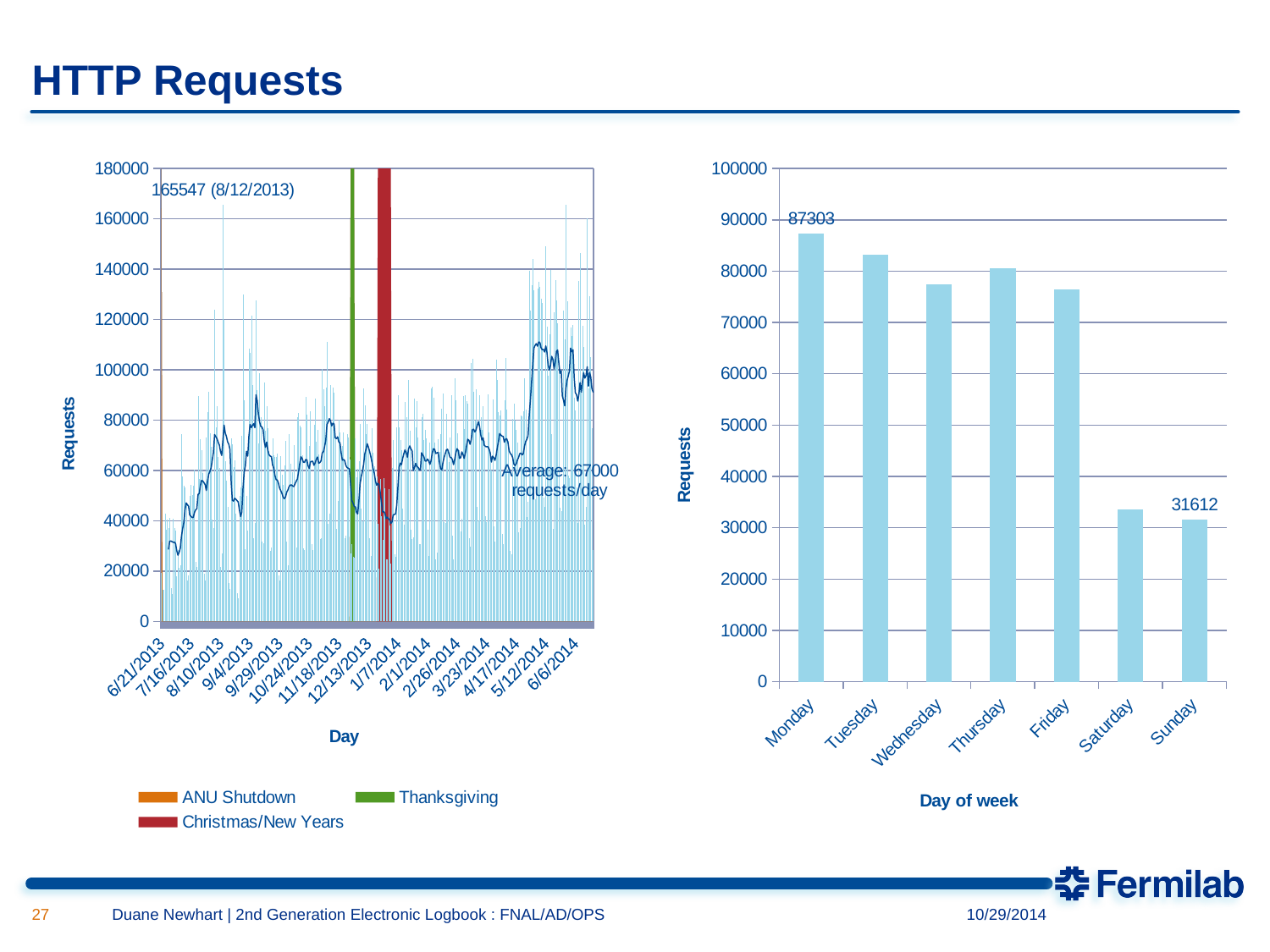
What kind of chart is the right chart (requests by day of week)? bar chart In the right chart (requests by day of week), which is larger, the value for Tuesday or the value for Wednesday? Tuesday In the right chart (requests by day of week), is the value for Tuesday greater or less than 80000? greater In the right chart (requests by day of week), what is the value for Monday? 87303 In the right chart (requests by day of week), what is the value for Sunday? 31612 In the right chart (requests by day of week), is the value for Wednesday greater or less than 80000? less In the left chart (requests per day), what peak value and date are annotated at the top? 165547 (8/12/2013) In the right chart (requests by day of week), which day has the highest number of requests? Monday How many days of the week are shown in the right chart? 7 In the right chart (requests by day of week), what is the difference between the Monday and Sunday values? 55691 In the right chart (requests by day of week), is the value for Saturday greater or less than 30000? greater In the right chart (requests by day of week), which day has the lowest number of requests? Sunday